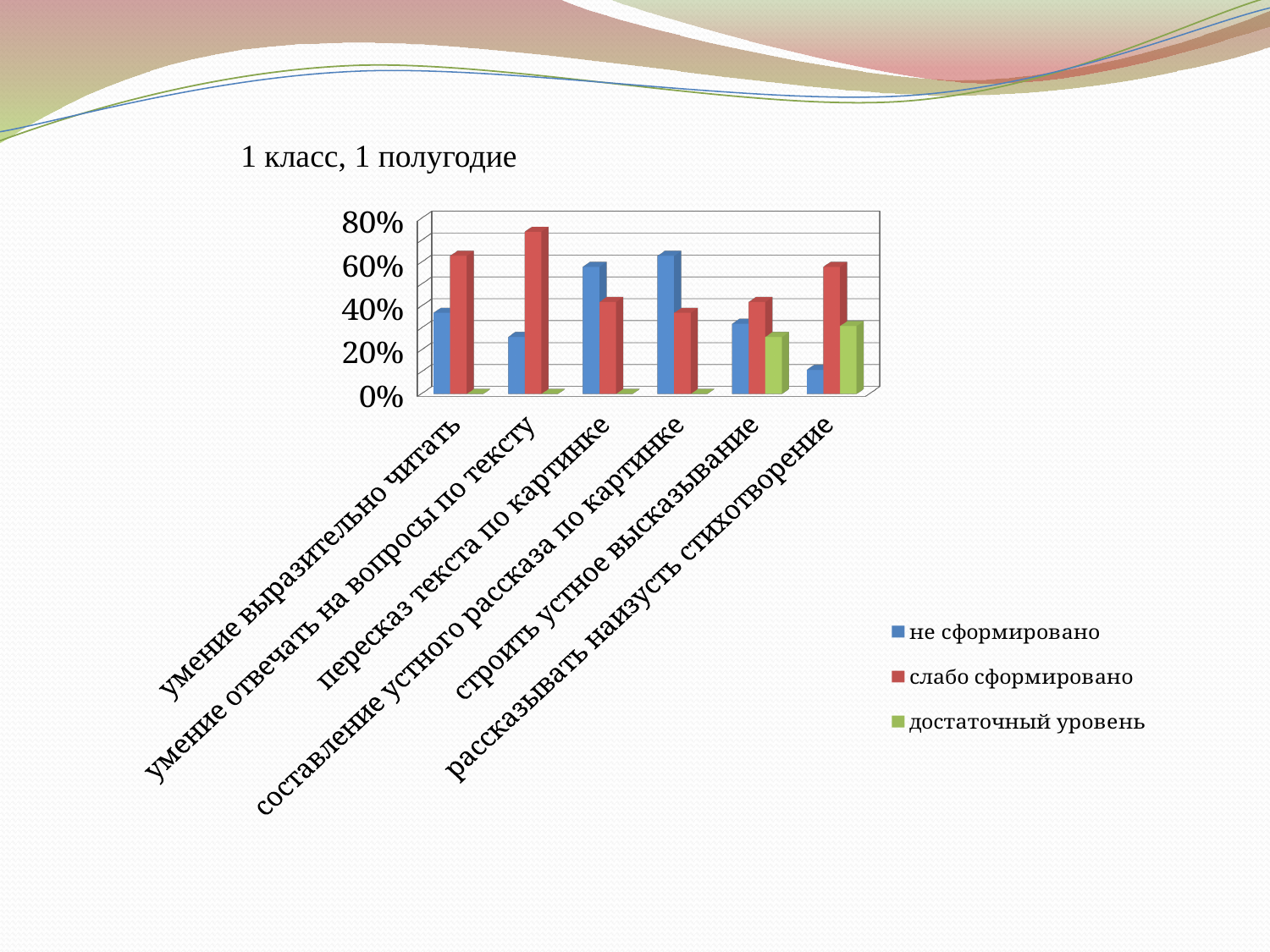
Which category has the highest value for 'слабо сформировано'? умение отвечать на вопросы по тексту For 'пересказ текста по картинке', which is larger: 'не сформировано' or 'слабо сформировано'? не сформировано Is the value of 'не сформировано' for 'рассказывать наизусть стихотворение' greater or less than 20%? less What is the title shown above the chart? 1 класс, 1 полугодие For 'умение отвечать на вопросы по тексту', which is larger: 'не сформировано' or 'слабо сформировано'? слабо сформировано How many categories are shown along the x axis of the chart? 6 Is the value of 'слабо сформировано' for 'умение отвечать на вопросы по тексту' greater or less than 60%? greater Which category has the lowest value for 'не сформировано'? рассказывать наизусть стихотворение Is the value of 'не сформировано' for 'составление устного рассказа по картинке' greater or less than 40%? greater How many series does the chart legend list? 3 What kind of chart is shown on the slide? bar chart Which series is shown in green in the chart legend? достаточный уровень